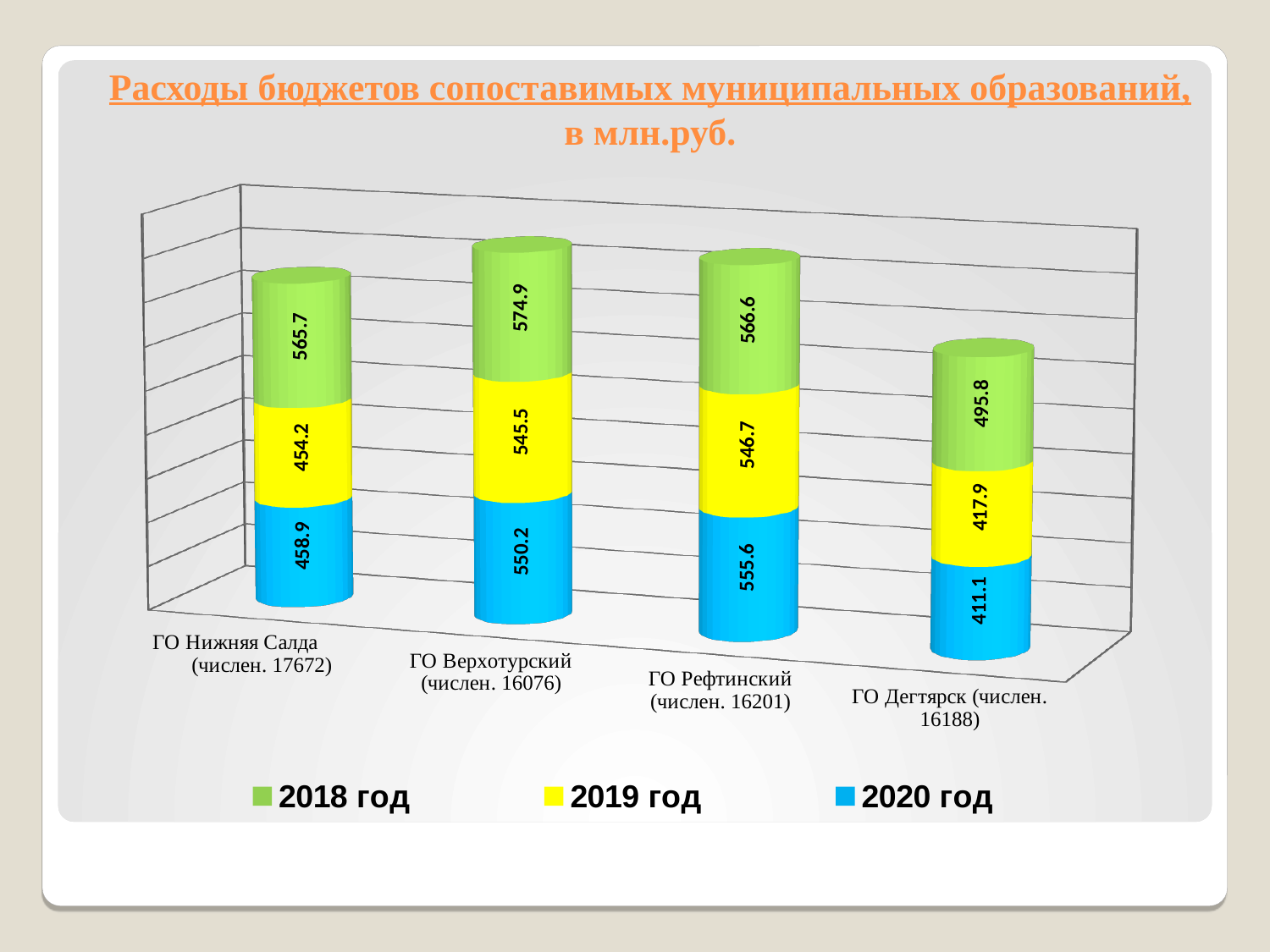
What kind of chart is shown on the slide? Stacked bar chart What is the 2018 год value for ГО Нижняя Салда? 565.7 Which is larger for ГО Верхотурский: the 2019 год value or the 2020 год value? 2020 год How many municipalities are shown on the chart? 4 What is the 2020 год value for ГО Рефтинский? 555.6 Which municipality has the lowest 2020 год value? ГО Дегтярск Which colour represents 2019 год in the legend? Yellow What is the 2019 год value for ГО Дегтярск? 417.9 How many series does the legend list? 3 Which municipality has the highest 2018 год value? ГО Верхотурский What is the total of the stacked bar for ГО Дегтярск? 1324.8 What is the difference between the 2018 год and 2019 год values for ГО Нижняя Салда? 111.5